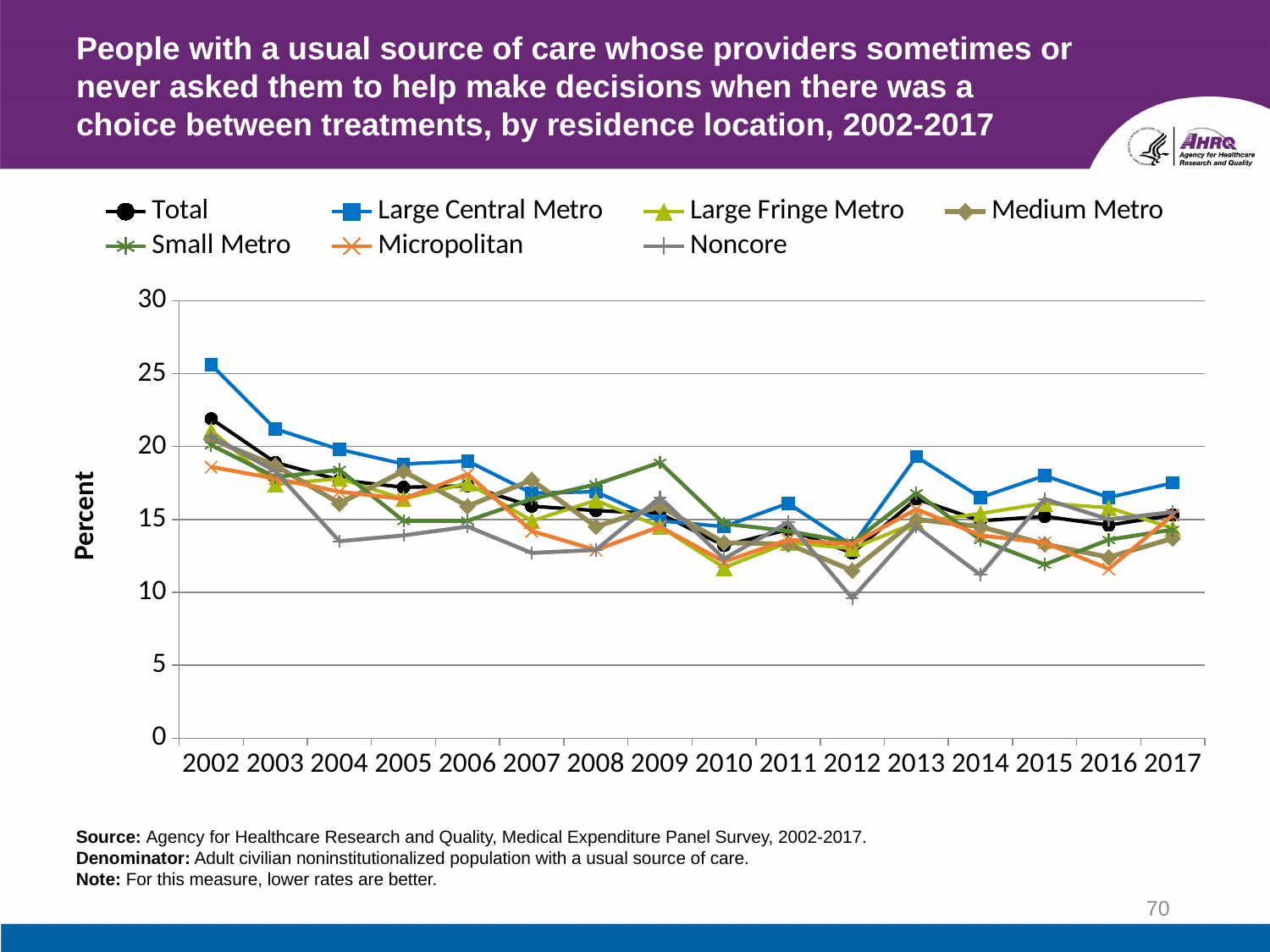
Which series has the highest value in 2013? Large Central Metro Is the value for Large Central Metro in 2002 greater or less than 20? greater Which series has the highest value in 2002? Large Central Metro Which series has the lowest value in 2012? Noncore What kind of chart is shown on the slide? line chart How many years are shown along the x axis? 16 In 2002, which is larger: the value for Large Central Metro or the value for Micropolitan? Large Central Metro What is the label on the y axis? Percent Does the Large Central Metro line rise or fall from 2002 to 2005? fall Is the value for Total in 2002 greater or less than 20? greater Is the value for Noncore in 2012 greater or less than 15? less How many series does the legend list? 7